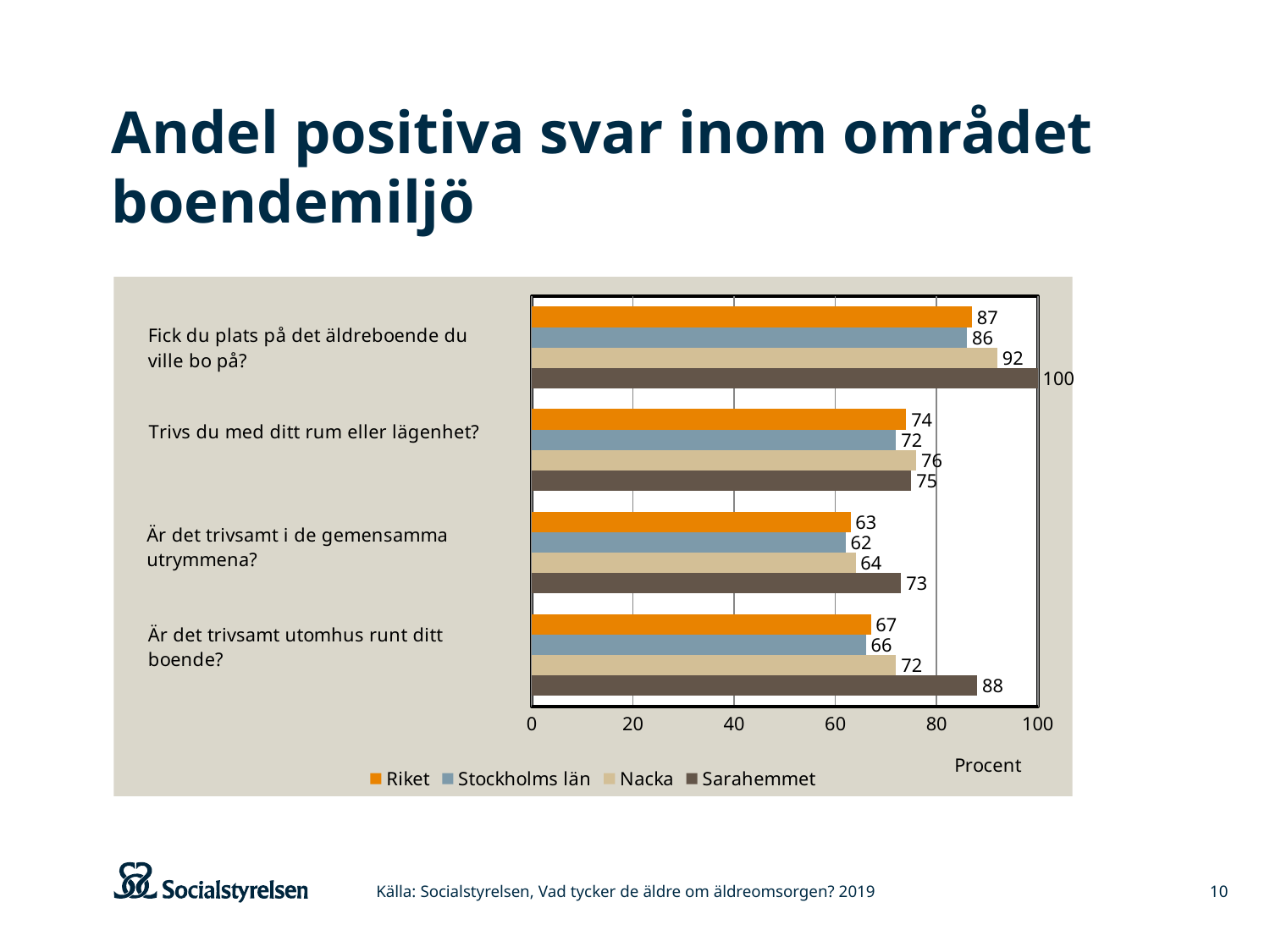
How many series does the legend list? 4 Which series has the lowest value on "Är det trivsamt i de gemensamma utrymmena?"? Stockholms län What is the value for Nacka on "Trivs du med ditt rum eller lägenhet?"? 76 What is the value for Stockholms län on "Är det trivsamt i de gemensamma utrymmena?"? 62 Which is larger on "Trivs du med ditt rum eller lägenhet?": Nacka or Stockholms län? Nacka What is the value for Sarahemmet on "Fick du plats på det äldreboende du ville bo på?"? 100 What is the value for Riket on "Är det trivsamt utomhus runt ditt boende?"? 67 How many questions (categories) are shown on the chart? 4 What is the difference between Sarahemmet and Riket on "Är det trivsamt utomhus runt ditt boende?"? 21 Which series has the highest value on "Är det trivsamt utomhus runt ditt boende?"? Sarahemmet What is the label on the horizontal axis of the chart? Procent What kind of chart is shown on the slide? Bar chart